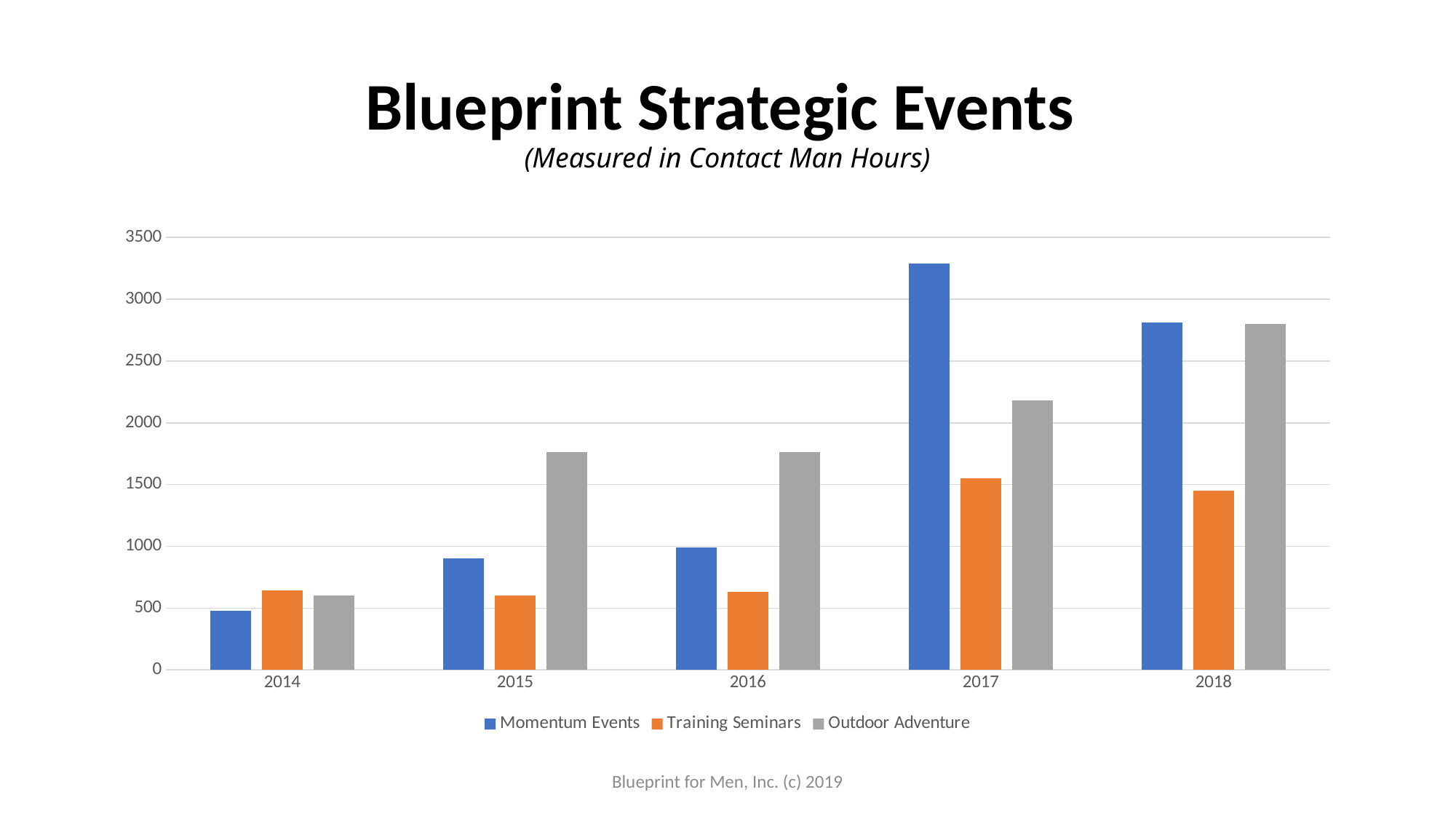
What kind of chart is shown on the slide? Bar chart In 2017, which is larger: Momentum Events or Outdoor Adventure? Momentum Events Do the Momentum Events values rise or fall from 2014 to 2017? rise In 2016, which is larger: Outdoor Adventure or Training Seminars? Outdoor Adventure How many series does the legend list? 3 In which year is the Momentum Events value highest? 2017 In which year is the Momentum Events value lowest? 2014 Is the Training Seminars value for 2014 greater or less than 1000? less Is the Momentum Events value for 2017 greater or less than 3000? greater Is the Outdoor Adventure value for 2015 greater or less than 1500? greater How many years are shown on the x axis? 5 According to the subtitle, in what unit are the values measured? Contact Man Hours